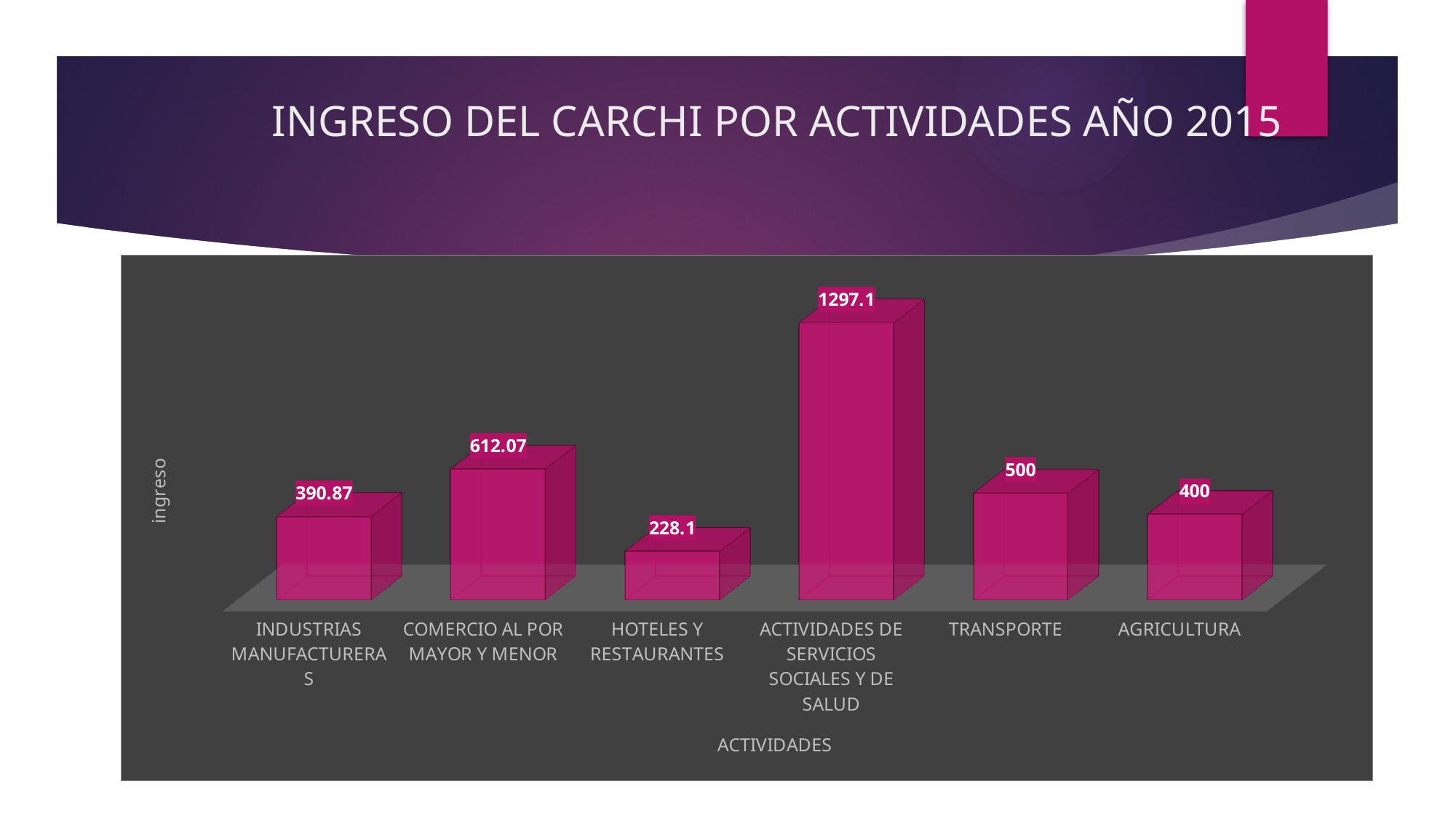
How many activities are shown in the chart? 6 What is the difference between the ingreso for TRANSPORTE and AGRICULTURA? 100 What is the ingreso value for INDUSTRIAS MANUFACTURERAS? 390.87 What is the title of the chart on the slide? INGRESO DEL CARCHI POR ACTIVIDADES AÑO 2015 What is the ingreso value for TRANSPORTE? 500 Which has a larger ingreso, AGRICULTURA or INDUSTRIAS MANUFACTURERAS? AGRICULTURA What kind of chart is shown on the slide? Bar chart Which activity has the highest ingreso? ACTIVIDADES DE SERVICIOS SOCIALES Y DE SALUD What is the difference between the ingreso for ACTIVIDADES DE SERVICIOS SOCIALES Y DE SALUD and COMERCIO AL POR MAYOR Y MENOR? 685.03 What is the ingreso value for HOTELES Y RESTAURANTES? 228.1 Which activity has the lowest ingreso? HOTELES Y RESTAURANTES What is the ingreso value for COMERCIO AL POR MAYOR Y MENOR? 612.07